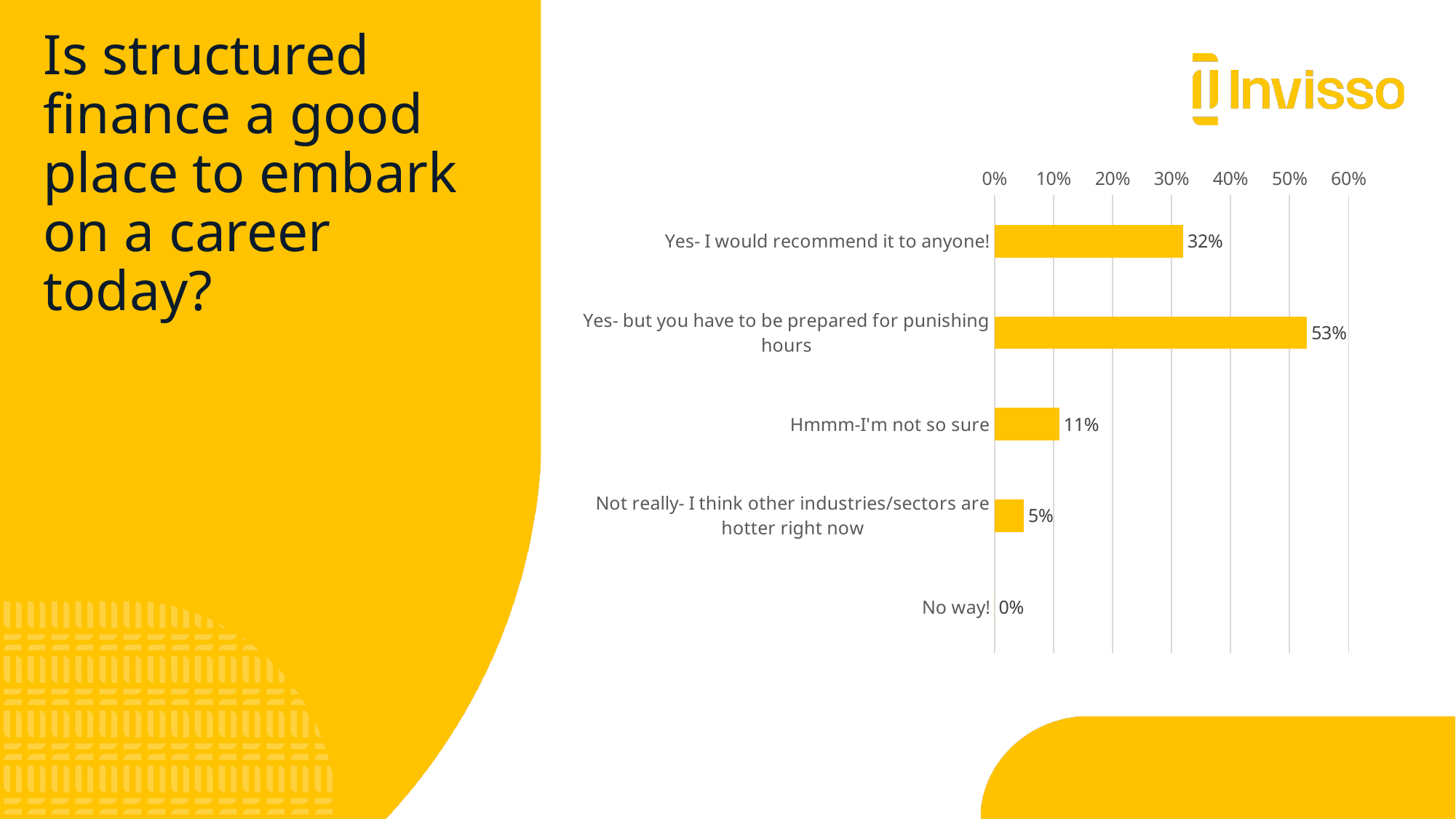
What percentage of respondents answered "Yes- I would recommend it to anyone!"? 32% What percentage chose "Hmmm-I'm not so sure"? 11% What is the value for "Yes- but you have to be prepared for punishing hours"? 53% What percentage of respondents answered "No way!"? 0% What kind of chart is shown on the slide? Bar chart Which response has the lowest percentage? No way! Which response has the highest percentage? Yes- but you have to be prepared for punishing hours What is the value for "Not really- I think other industries/sectors are hotter right now"? 5% Which is larger: "Hmmm-I'm not so sure" or "Not really- I think other industries/sectors are hotter right now"? Hmmm-I'm not so sure How many response categories are shown in the chart? 5 Is the value for "Yes- but you have to be prepared for punishing hours" greater or less than 50%? greater What is the difference between "Yes- but you have to be prepared for punishing hours" and "Yes- I would recommend it to anyone!"? 21%